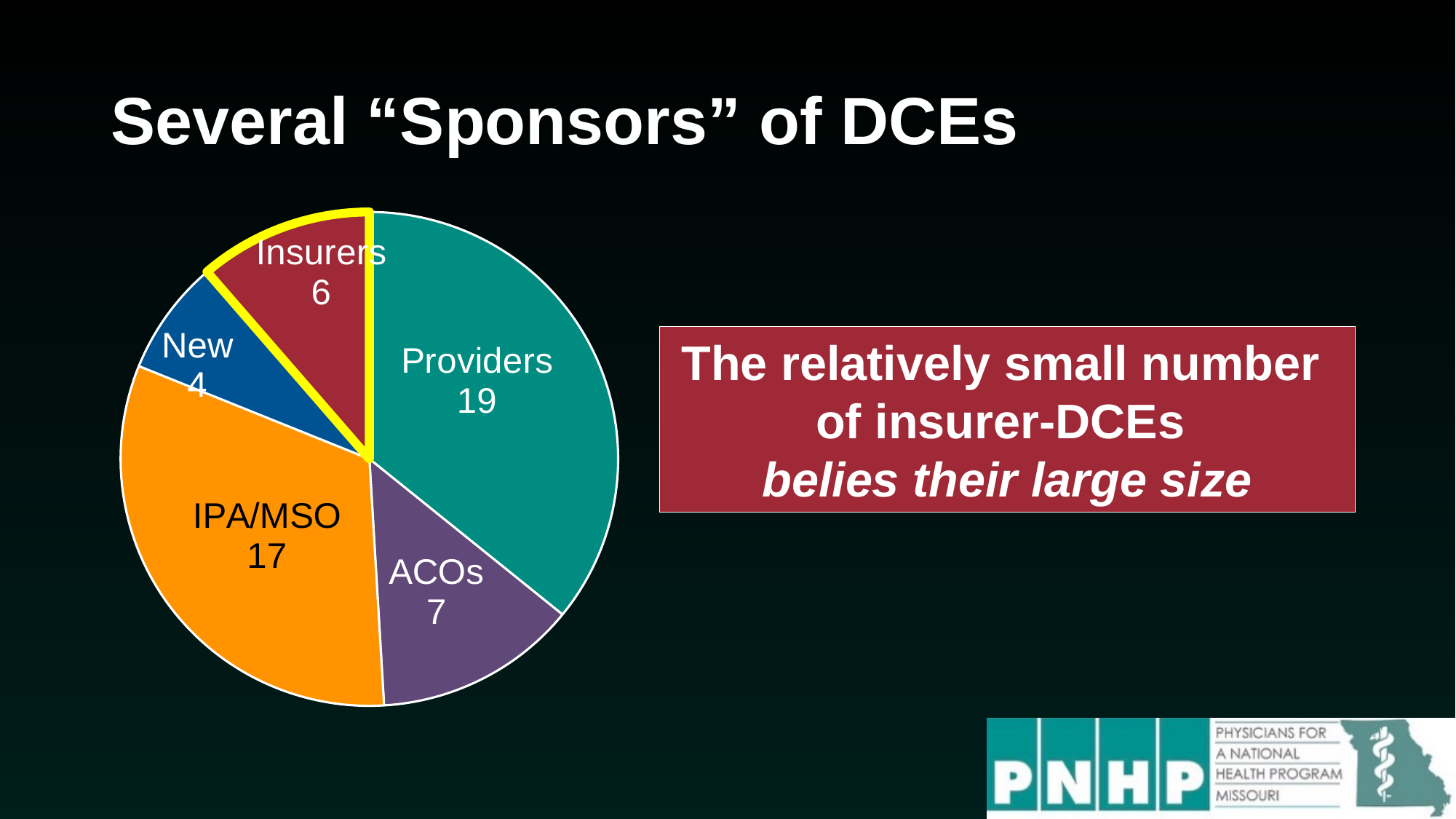
What is the value shown for the Insurers slice of the pie chart? 6 What value is shown for IPA/MSO in the pie chart? 17 What is the difference between the Providers value and the IPA/MSO value? 2 How many DCEs are sponsored by Providers according to the pie chart? 19 Which sponsor category has the smallest slice of the pie chart? New What kind of chart is shown on the slide? pie chart Which slice of the pie chart is outlined in yellow? Insurers How many sponsor categories are shown in the pie chart? 5 What is the total of all the values shown in the pie chart? 53 Which sponsor category has the largest slice of the pie chart? Providers What value is shown for the New slice? 4 Which is larger, the ACOs slice or the Insurers slice? ACOs